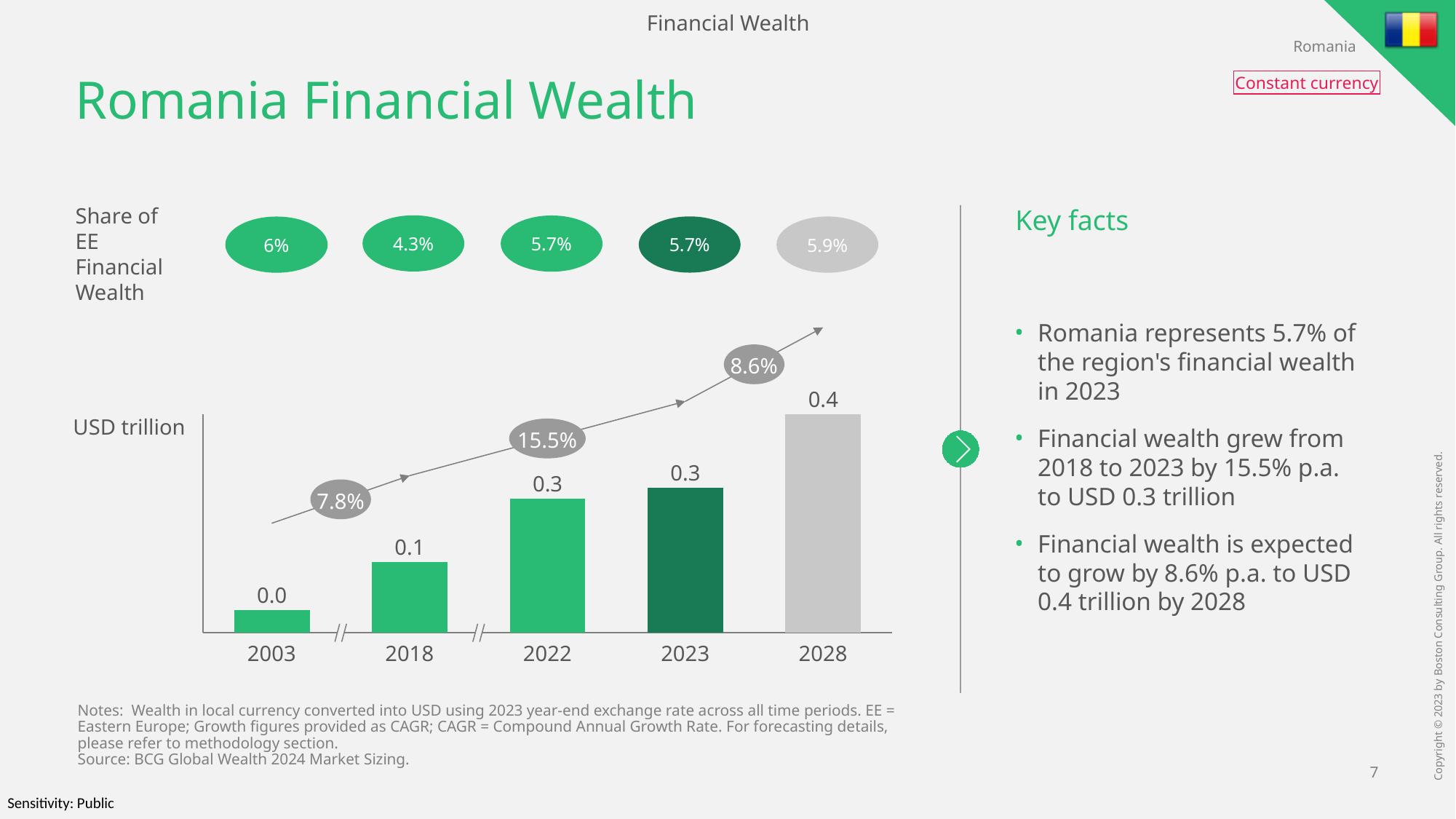
What is the financial wealth value shown for 2028? 0.4 Do the financial wealth bars rise or fall from 2003 to 2028? rise What is the financial wealth value shown for 2003? 0.0 What CAGR is shown between 2018 and 2023? 15.5% What kind of chart is used to show financial wealth in USD trillion? bar chart Which year has the lowest financial wealth bar? 2003 Which year has the highest financial wealth bar? 2028 How many years are shown on the x axis of the chart? 5 What is the difference between the financial wealth values for 2028 and 2018? 0.3 What share of EE financial wealth is shown for 2018? 4.3% What is the financial wealth value shown for 2018? 0.1 Is the financial wealth bar for 2028 larger or smaller than the bar for 2022? larger